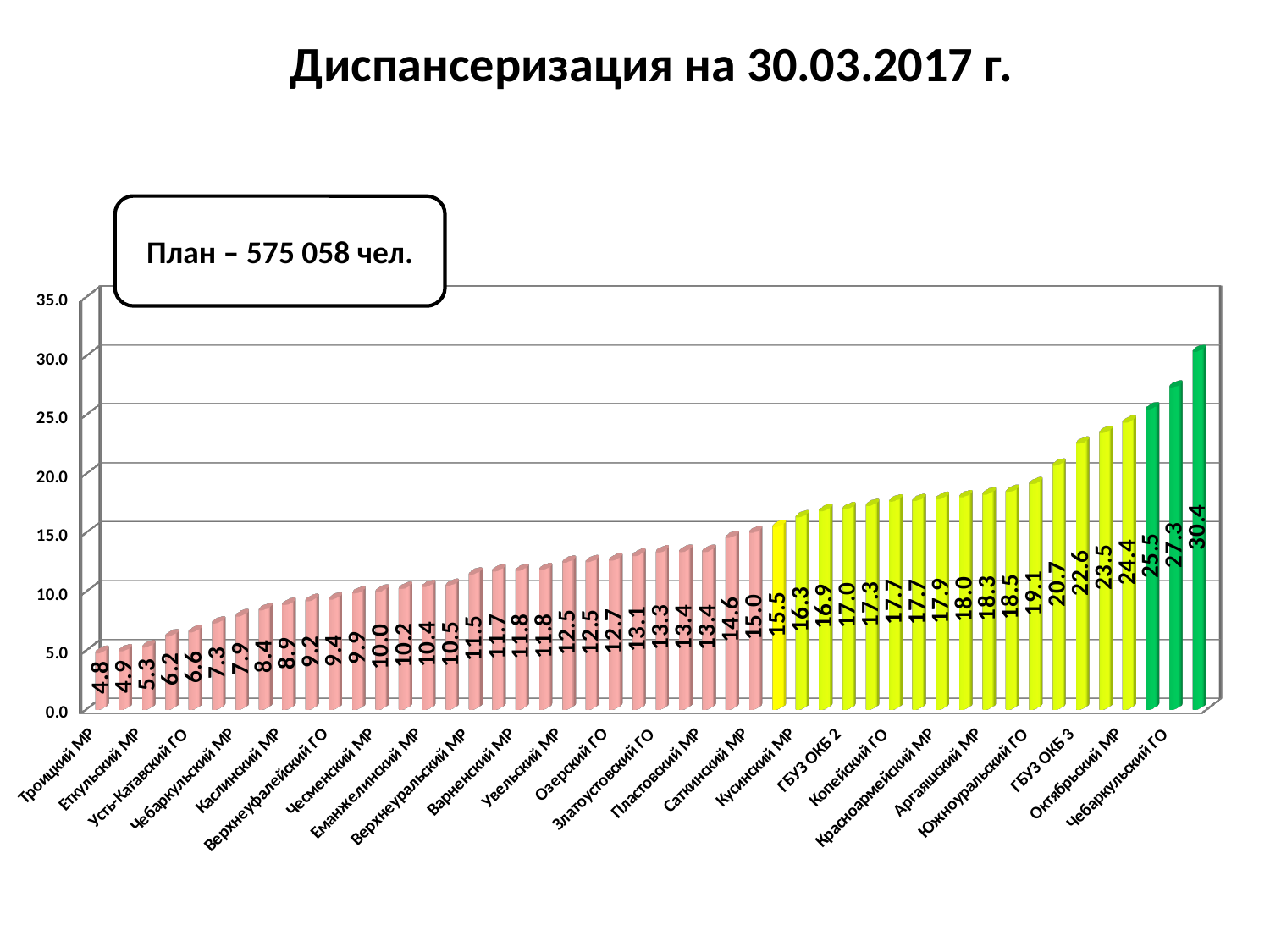
What is the highest value shown on the chart? 30.4 How many bars are plotted on the chart? 48 Is the highest bar on the chart greater or less than 30.0? greater What is the value of the single yellow bar on the chart? 15.5 What kind of chart is shown on the slide? bar chart What is the maximum value shown on the vertical axis? 35.0 What plan figure is shown in the callout box on the slide? 575 058 чел. How many bars are coloured green on the chart? 3 What is the difference between the highest value (30.4) and the lowest value (4.8) on the chart? 25.6 What is the lowest value shown on the chart? 4.8 Do the bar values rise or fall from left to right along the x axis? rise What is the title of the slide? Диспансеризация на 30.03.2017 г.